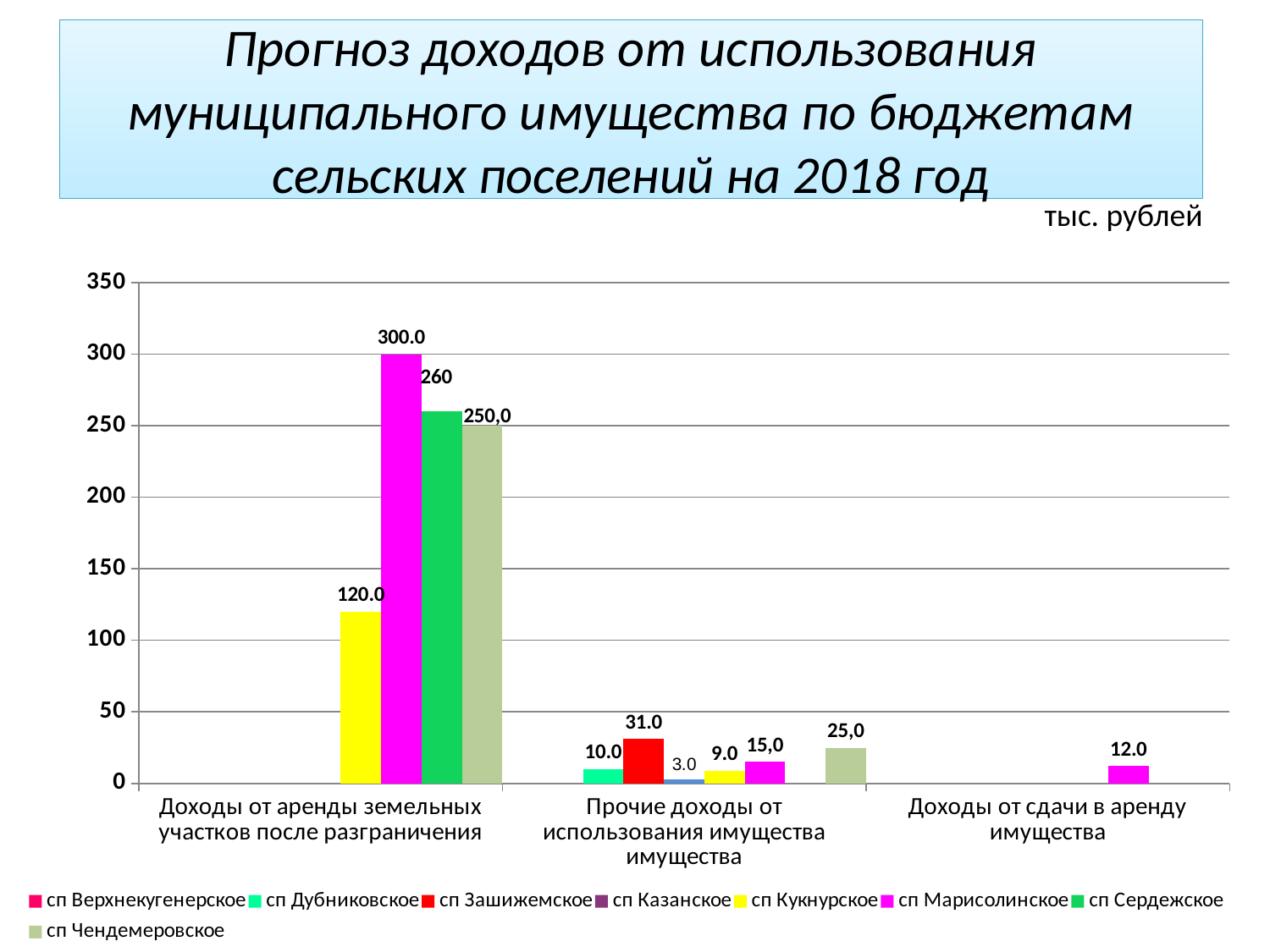
In the category 'Доходы от аренды земельных участков после разграничения', how much larger is the value for сп Марисолинское than for сп Сердежское? 40 What is the value for сп Марисолинское in the category 'Доходы от сдачи в аренду имущества'? 12.0 What is the smallest labelled value in the category 'Прочие доходы от использования имущества'? 3.0 In the category 'Прочие доходы от использования имущества', which is larger: the value for сп Чендемеровское or for сп Дубниковское? сп Чендемеровское Which series has the highest value in the category 'Доходы от аренды земельных участков после разграничения'? сп Марисолинское What is the value for сп Зашижемское in the category 'Прочие доходы от использования имущества'? 31.0 What is the value for сп Кукнурское in the category 'Доходы от аренды земельных участков после разграничения'? 120.0 What is the value for сп Марисолинское in the category 'Доходы от аренды земельных участков после разграничения'? 300.0 How many series does the legend list? 8 How many categories are shown on the x axis? 3 In what units are the values on the chart expressed, according to the slide? тыс. рублей What kind of chart is shown on the slide? bar chart